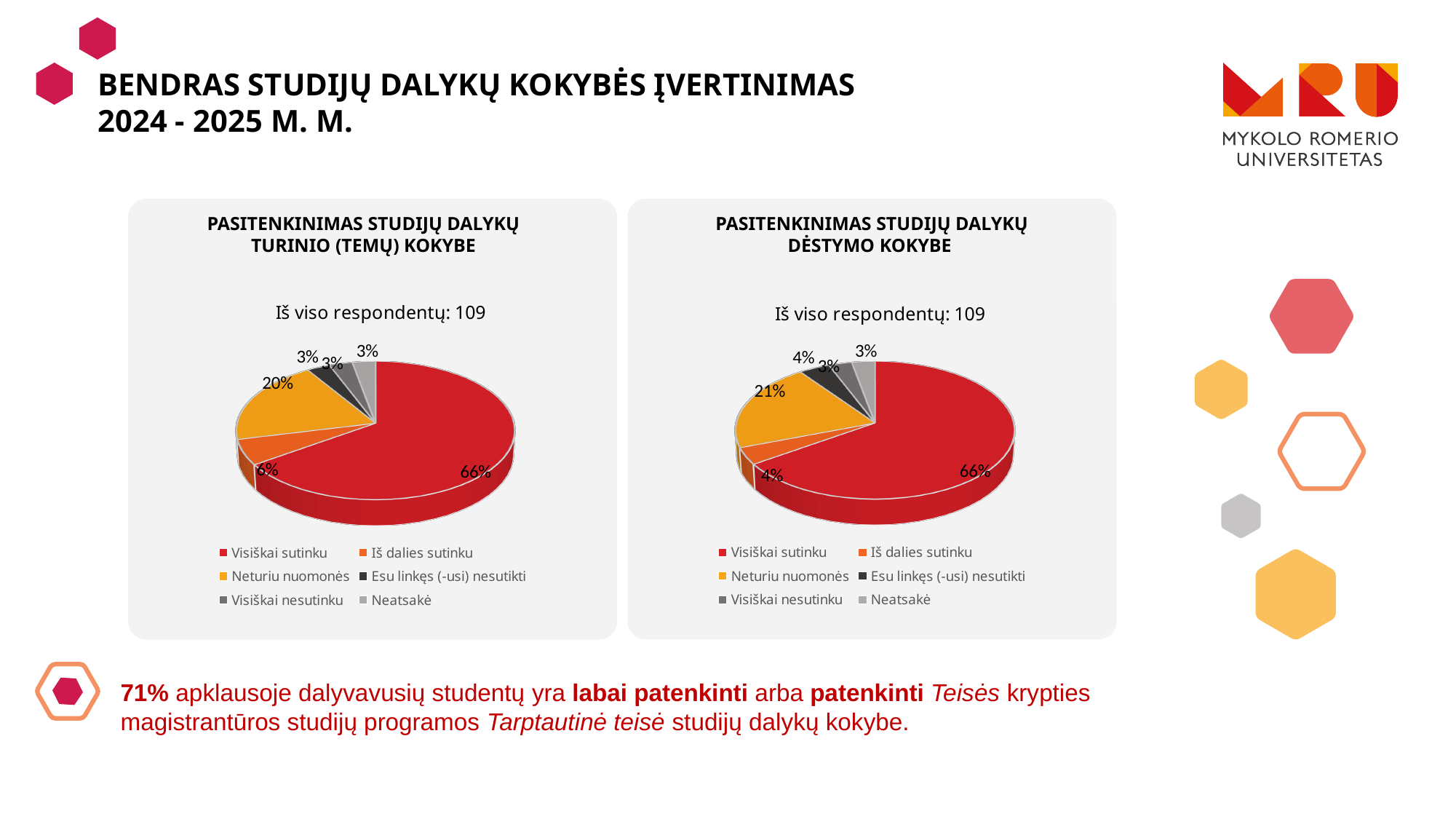
In the 'Pasitenkinimas studijų dalykų dėstymo kokybe' chart, what share is labelled for 'Neturiu nuomonės'? 21% In the 'Pasitenkinimas studijų dalykų turinio (temų) kokybe' chart, what share is labelled for 'Iš dalies sutinku'? 6% In the 'Pasitenkinimas studijų dalykų turinio (temų) kokybe' chart, what is the difference between the 'Visiškai sutinku' and 'Neturiu nuomonės' shares? 46 percentage points Which is larger in the 'Pasitenkinimas studijų dalykų dėstymo kokybe' chart: the 'Neturiu nuomonės' slice or the 'Iš dalies sutinku' slice? Neturiu nuomonės How many categories does the legend of the 'Pasitenkinimas studijų dalykų dėstymo kokybe' chart list? 6 In the 'Pasitenkinimas studijų dalykų turinio (temų) kokybe' chart, what colour is the 'Visiškai sutinku' slice? Red In the 'Pasitenkinimas studijų dalykų dėstymo kokybe' chart, what share is labelled for 'Iš dalies sutinku'? 4% In the 'Pasitenkinimas studijų dalykų dėstymo kokybe' chart, which category has the largest slice? Visiškai sutinku What type of chart is used in the 'Pasitenkinimas studijų dalykų turinio (temų) kokybe' panel? Pie chart How many respondents are reported for the 'Pasitenkinimas studijų dalykų turinio (temų) kokybe' chart? 109 In the 'Pasitenkinimas studijų dalykų turinio (temų) kokybe' chart, what share is labelled for 'Neturiu nuomonės'? 20% In the 'Pasitenkinimas studijų dalykų turinio (temų) kokybe' chart, what share is labelled for 'Visiškai sutinku'? 66%